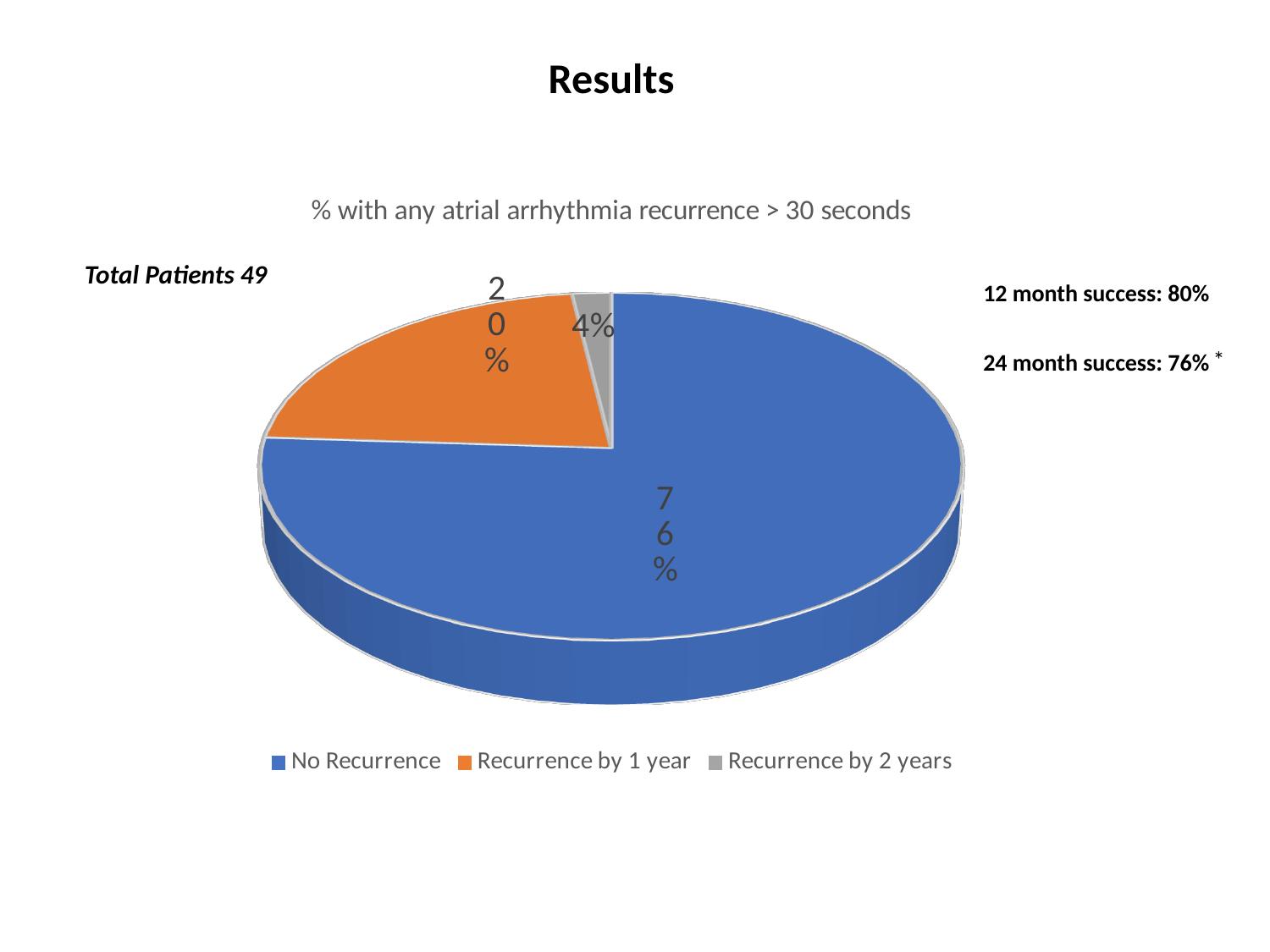
What is the combined share of the two recurrence slices (Recurrence by 1 year and Recurrence by 2 years)? 24% Which category has the largest slice of the pie? No Recurrence Which slice is larger: Recurrence by 1 year or Recurrence by 2 years? Recurrence by 1 year What is the title of the chart? % with any atrial arrhythmia recurrence > 30 seconds What is the difference in percentage points between the No Recurrence slice and the Recurrence by 1 year slice? 56 How many categories does the legend list? 3 What colour is the No Recurrence slice? blue What percentage of the pie is labelled for Recurrence by 1 year? 20% What percentage of the pie is labelled for Recurrence by 2 years? 4% What kind of chart is shown on the slide? pie chart Which category has the smallest slice of the pie? Recurrence by 2 years What percentage of the pie is labelled for No Recurrence? 76%